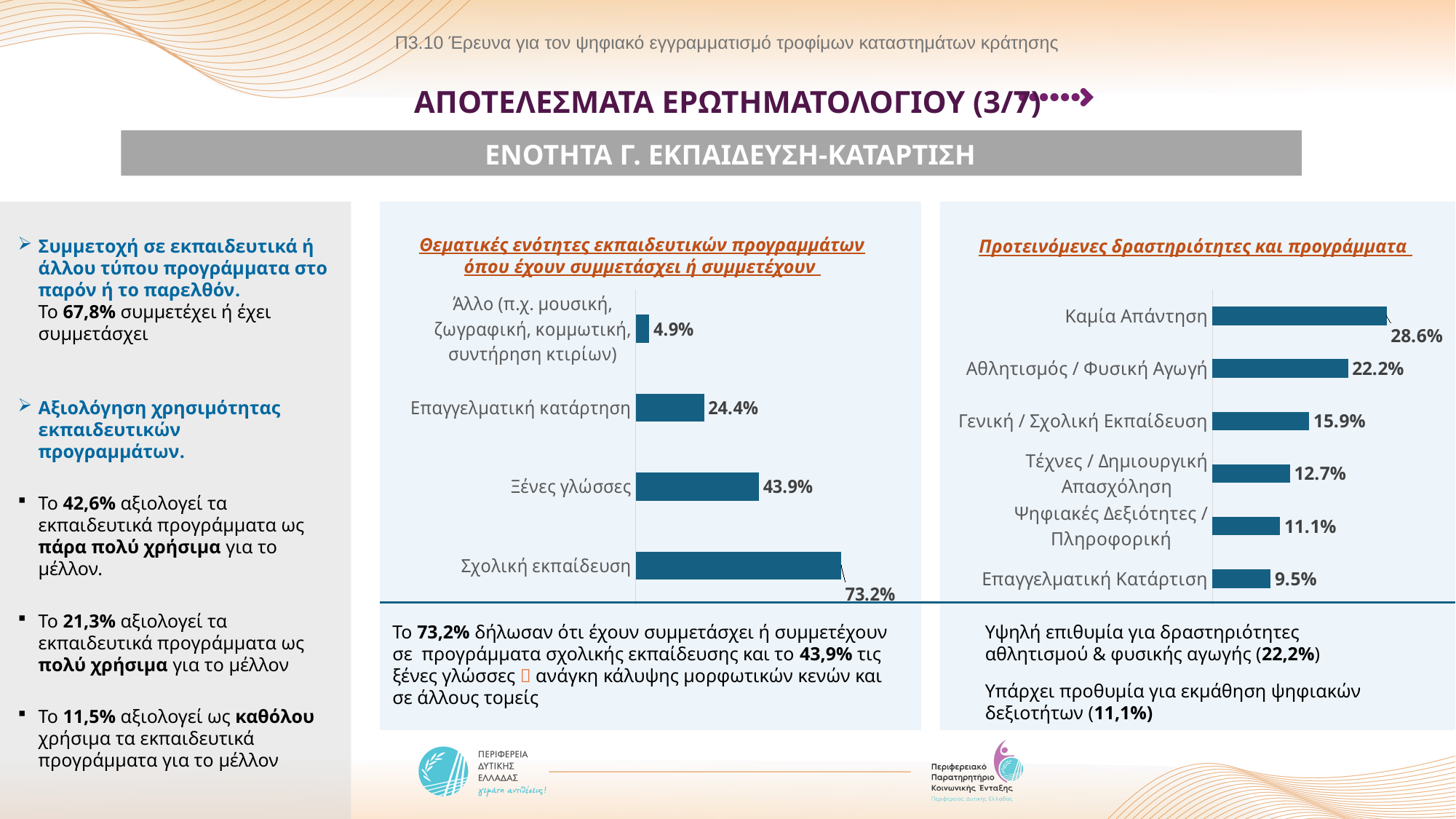
In the right chart (Προτεινόμενες δραστηριότητες και προγράμματα), which category has the lowest value? Επαγγελματική Κατάρτιση What type of chart is the left chart (Θεματικές ενότητες εκπαιδευτικών προγραμμάτων)? Bar chart In the right chart (Προτεινόμενες δραστηριότητες και προγράμματα), which is larger: Γενική / Σχολική Εκπαίδευση or Τέχνες / Δημιουργική Απασχόληση? Γενική / Σχολική Εκπαίδευση In the left chart (Θεματικές ενότητες εκπαιδευτικών προγραμμάτων), how many categories are shown? 4 In the left chart (Θεματικές ενότητες εκπαιδευτικών προγραμμάτων), what is the value for Σχολική εκπαίδευση? 73.2% In the right chart (Προτεινόμενες δραστηριότητες και προγράμματα), what is the value for Ψηφιακές Δεξιότητες / Πληροφορική? 11.1% In the right chart (Προτεινόμενες δραστηριότητες και προγράμματα), what is the value for Αθλητισμός / Φυσική Αγωγή? 22.2% In the right chart (Προτεινόμενες δραστηριότητες και προγράμματα), how many categories are shown? 6 In the right chart (Προτεινόμενες δραστηριότητες και προγράμματα), which category has the highest value? Καμία Απάντηση In the left chart (Θεματικές ενότητες εκπαιδευτικών προγραμμάτων), which category has the lowest value? Άλλο (π.χ. μουσική, ζωγραφική, κομμωτική, συντήρηση κτιρίων) In the left chart (Θεματικές ενότητες εκπαιδευτικών προγραμμάτων), what is the value for Ξένες γλώσσες? 43.9% In the left chart (Θεματικές ενότητες εκπαιδευτικών προγραμμάτων), what is the difference between Σχολική εκπαίδευση and Επαγγελματική κατάρτηση? 48.8%